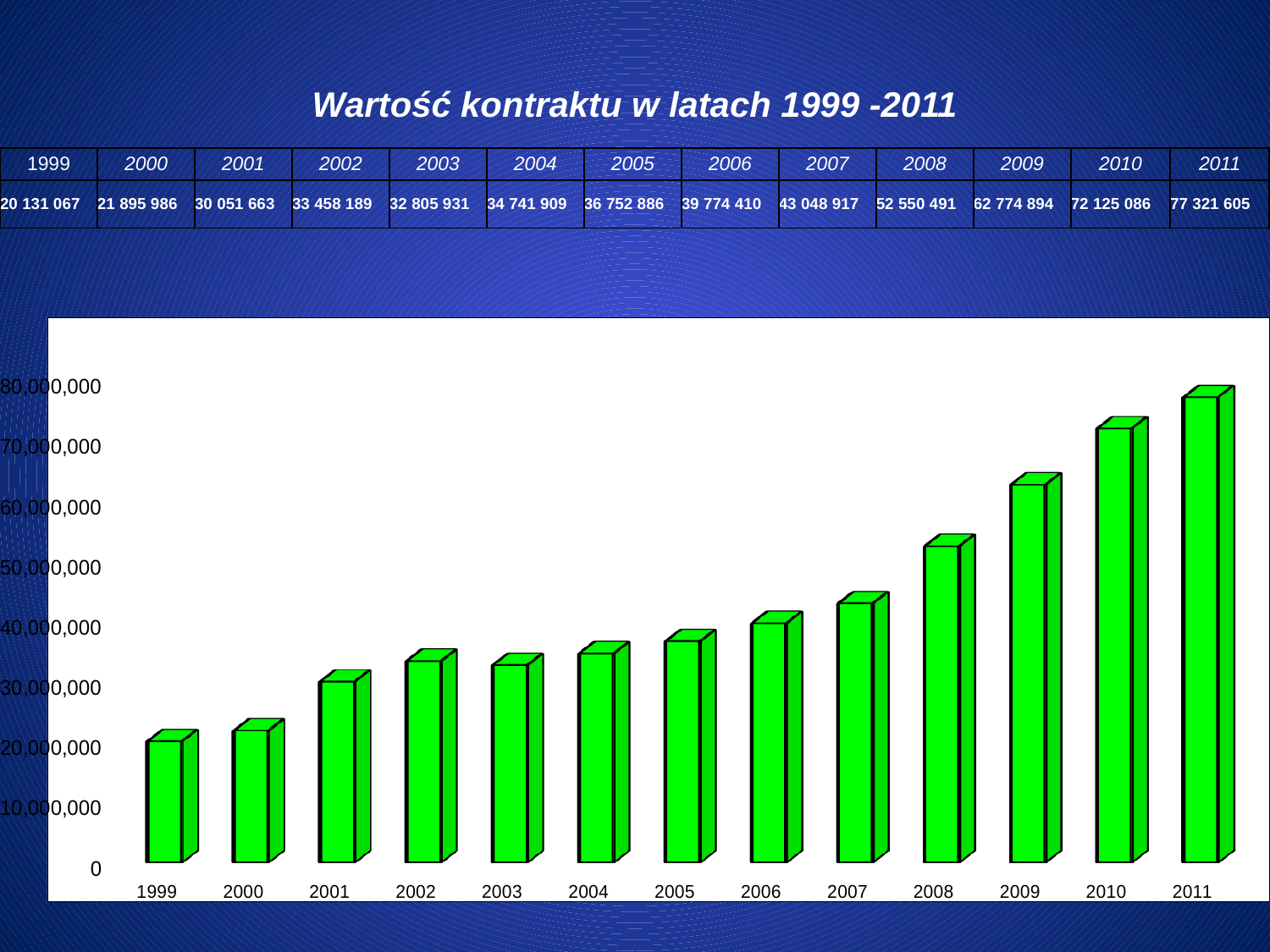
Which year has the highest contract value? 2011 Do the contract values generally rise or fall from 1999 to 2011? rise What is the difference between the contract values for 2010 and 2009? 9 350 192 What kind of chart is shown on the slide? bar chart What is the contract value for 1999? 20 131 067 Which year has the lowest contract value? 1999 Is the value for 2008 greater or less than 50,000,000? greater What is the contract value for 2008? 52 550 491 Which year has the larger contract value, 2007 or 2006? 2007 How many years are shown on the chart? 13 What is the difference between the contract values for 2011 and 1999? 57 190 538 What is the contract value for 2011? 77 321 605